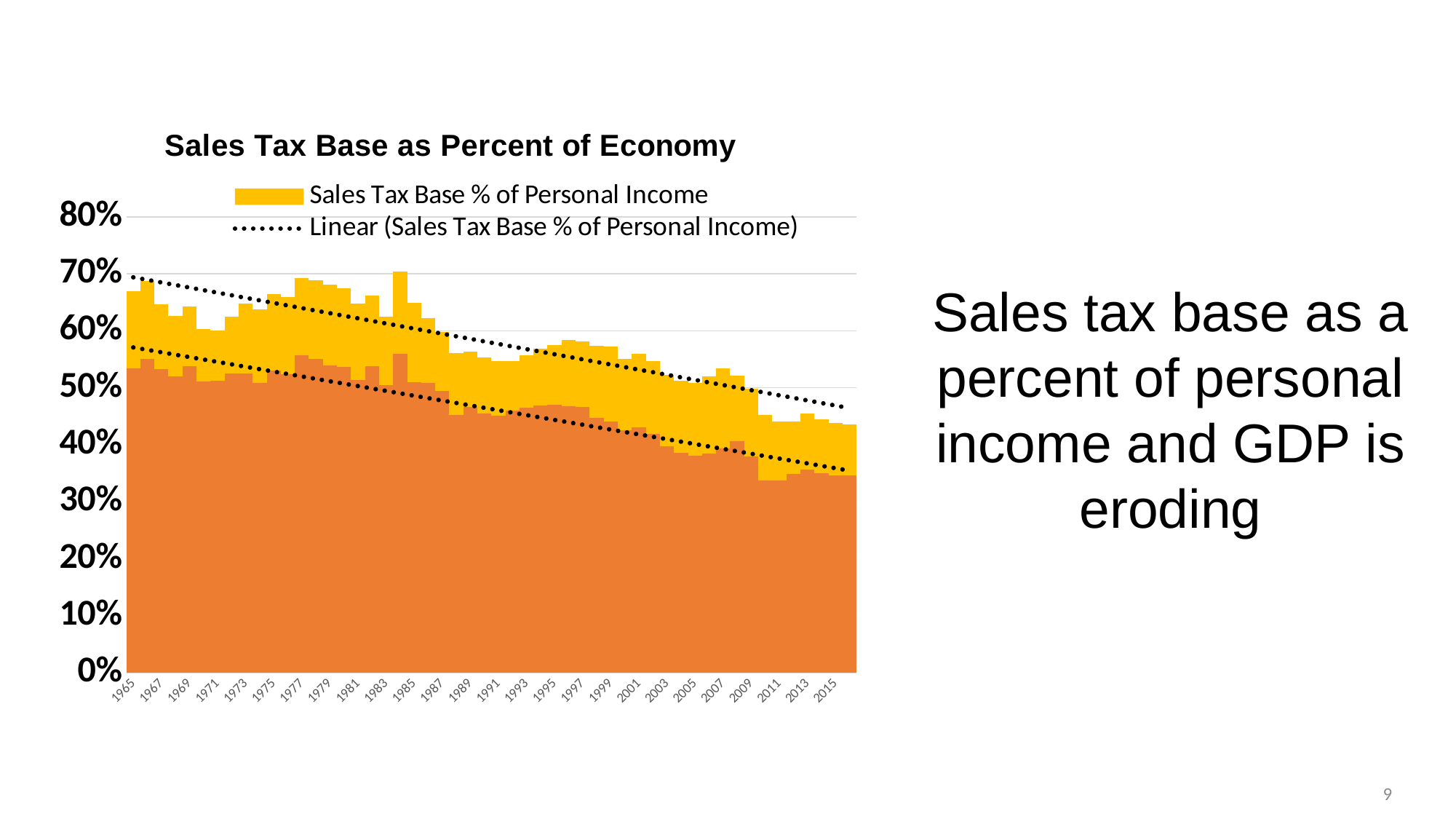
Which year has the larger value for the lower (orange) series, 1975 or 2005? 1975 How many entries does the chart legend list? 2 What kind of chart is shown on the slide? Bar chart How is the linear trendline for Sales Tax Base % of Personal Income drawn on the chart? As a black dotted line Is the Sales Tax Base % of Personal Income value for 2015 greater or less than 50%? less What is the title of the chart? Sales Tax Base as Percent of Economy Is the value of the lower (orange) series for 1965 greater or less than 50%? greater Is the Sales Tax Base % of Personal Income value for 2005 greater or less than 60%? less Which year has the larger Sales Tax Base % of Personal Income value, 1965 or 2015? 1965 Does the Sales Tax Base % of Personal Income series generally rise or fall from 1965 to 2015? Fall